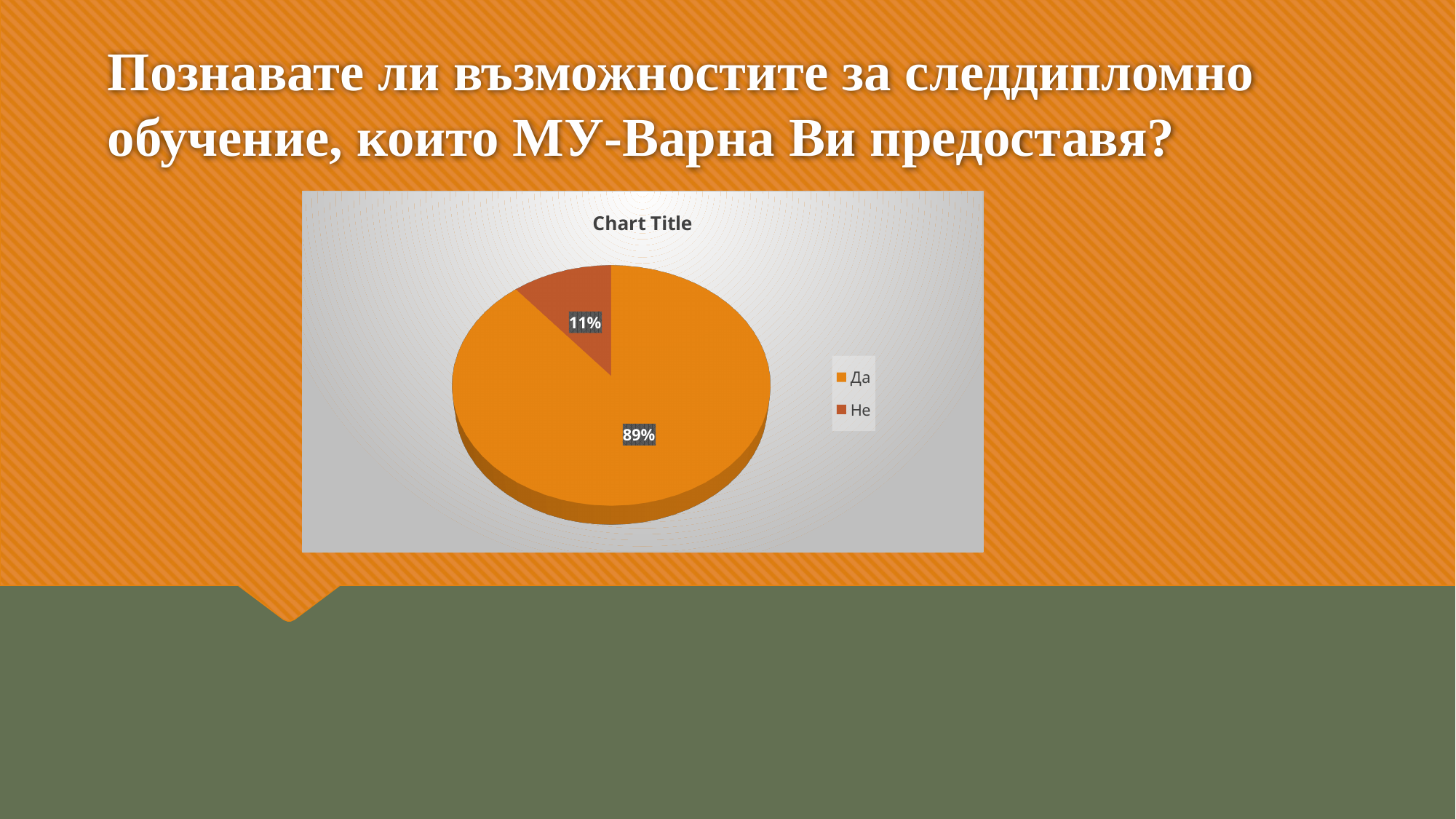
Which category has the largest slice of the pie? Да What is the title shown on the chart? Chart Title How many entries does the legend list? 2 What kind of chart is shown on the slide? pie chart What is the difference in percentage points between the "Да" and "Не" slices? 78 How many slices does the pie chart have? 2 What colour is the "Не" slice in the pie chart? dark brown-red Which category has the smallest slice of the pie? Не Which slice is larger, "Да" or "Не"? Да What share of the pie does the "Не" slice represent? 11% What share of the pie does the "Да" slice represent? 89%